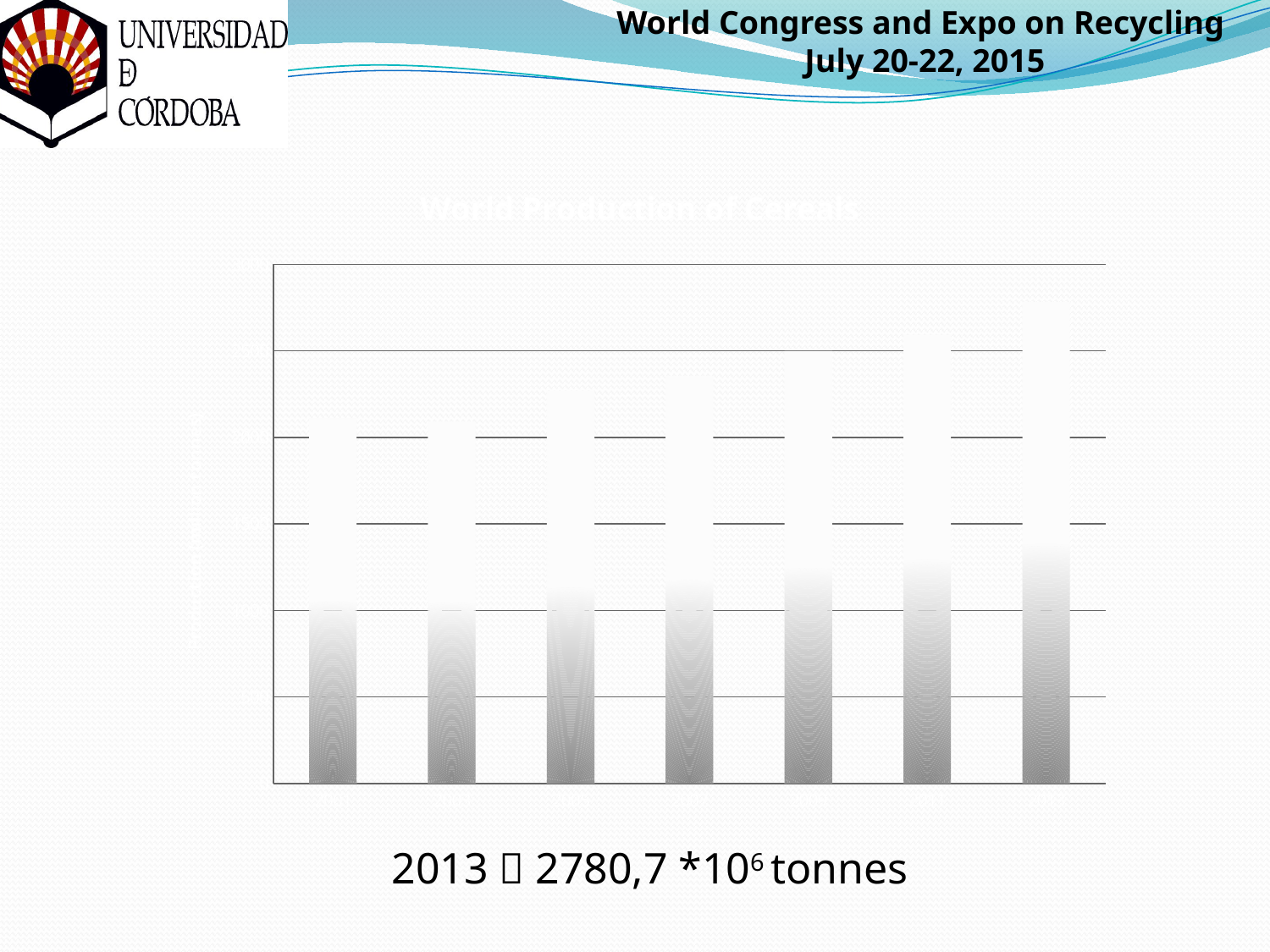
Which bar is the shortest in the chart, the leftmost or the rightmost? leftmost What kind of chart is shown on the slide? bar chart How many bars are plotted in the chart? 7 What is the title of the chart? World Production of Cereals Which bar is the tallest in the chart, the leftmost or the rightmost? rightmost Do the bar values rise or fall from left to right across the chart? rise Which is larger, the second bar from the left or the second bar from the right? second bar from the right